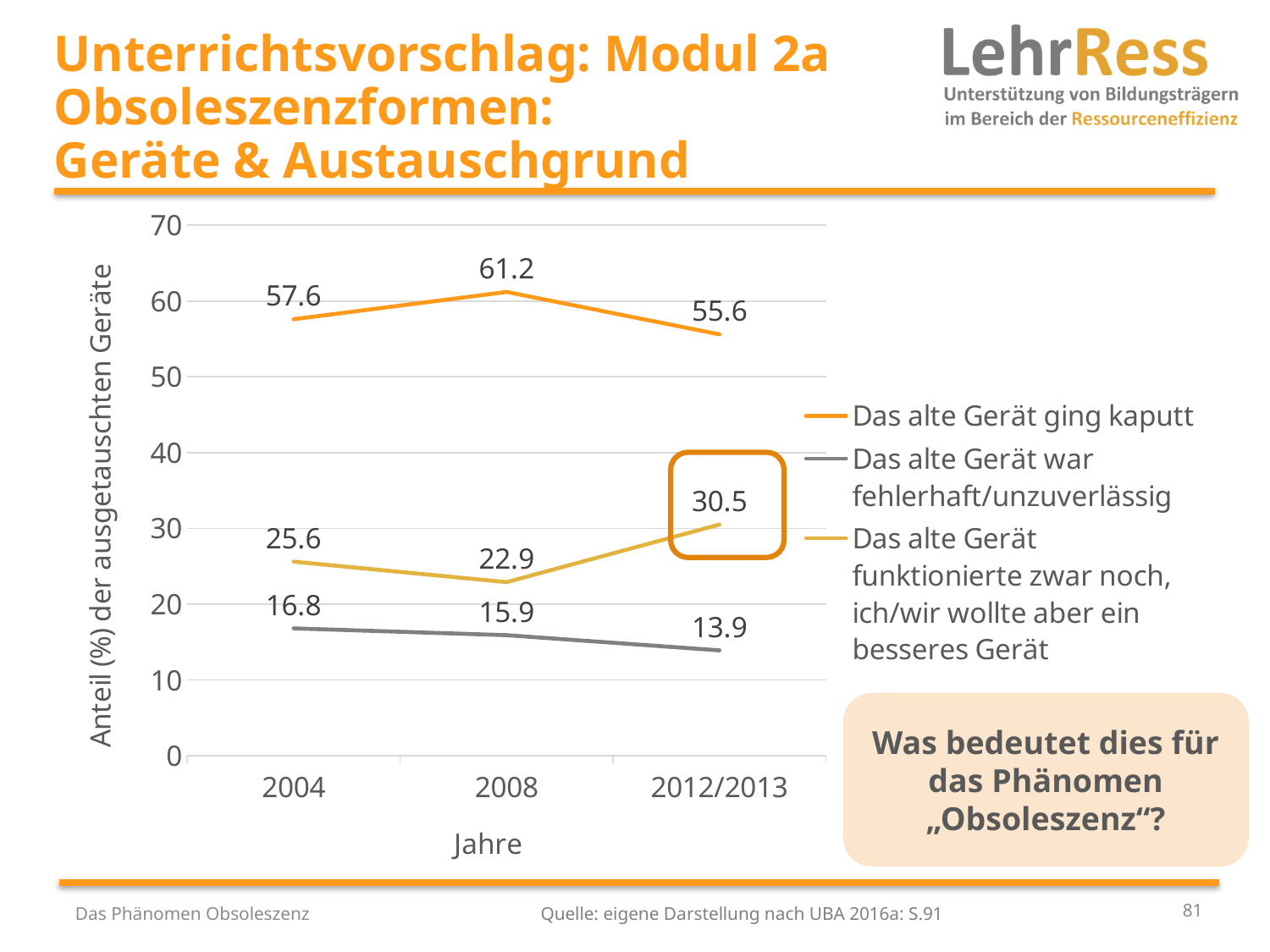
Is the 2012/2013 value for "Das alte Gerät ging kaputt" greater or less than 50? greater What is the value in 2004 for the series "Das alte Gerät funktionierte zwar noch, ich/wir wollte aber ein besseres Gerät"? 25.6 What kind of chart is shown on the slide? line chart In which year is the value for "Das alte Gerät war fehlerhaft/unzuverlässig" lowest? 2012/2013 How many years are shown on the x axis? 3 Does the series "Das alte Gerät war fehlerhaft/unzuverlässig" rise or fall from 2004 to 2012/2013? fall In which year does "Das alte Gerät ging kaputt" reach its highest value? 2008 What is the value for "Das alte Gerät war fehlerhaft/unzuverlässig" in 2012/2013? 13.9 How many series does the legend list? 3 What is the difference between the 2008 and 2012/2013 values for "Das alte Gerät ging kaputt"? 5.6 Which series has the larger value in 2012/2013: "Das alte Gerät war fehlerhaft/unzuverlässig" or "Das alte Gerät funktionierte zwar noch, ich/wir wollte aber ein besseres Gerät"? Das alte Gerät funktionierte zwar noch, ich/wir wollte aber ein besseres Gerät What is the value for "Das alte Gerät ging kaputt" in 2008? 61.2